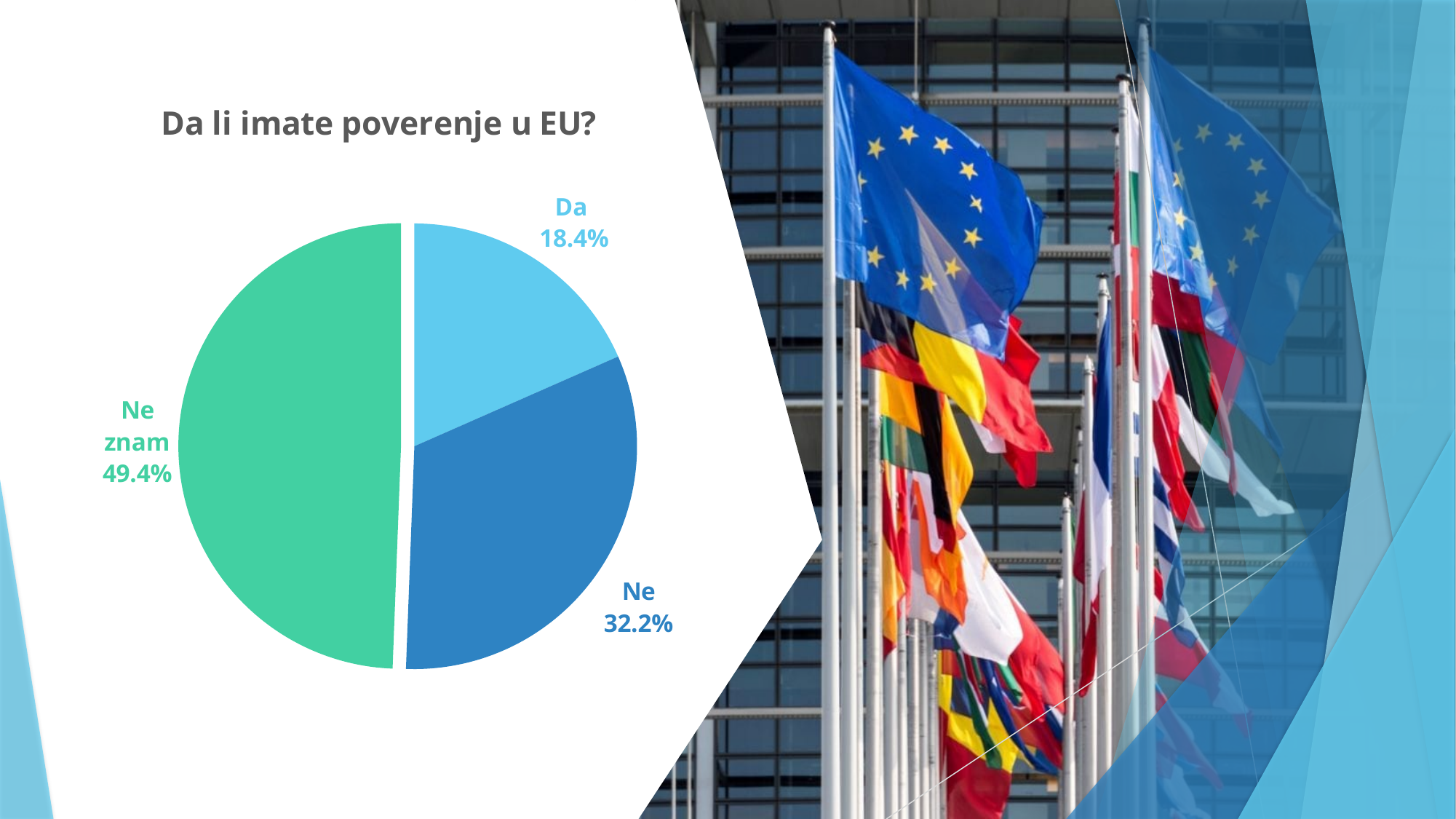
How many slices does the pie chart have? 3 What percentage of respondents answered "Da"? 18.4% What kind of chart is shown on the slide? Pie chart What percentage of respondents answered "Ne"? 32.2% Which response has the smallest share of the pie? Da What is the difference in percentage points between "Ne" and "Da"? 13.8 What is the title of the chart? Da li imate poverenje u EU? Which response has the largest share of the pie? Ne znam Which is larger, the share for "Ne" or the share for "Da"? Ne What is the difference in percentage points between "Ne znam" and "Ne"? 17.2 What colour is the "Ne znam" slice? Green What percentage of respondents answered "Ne znam"? 49.4%